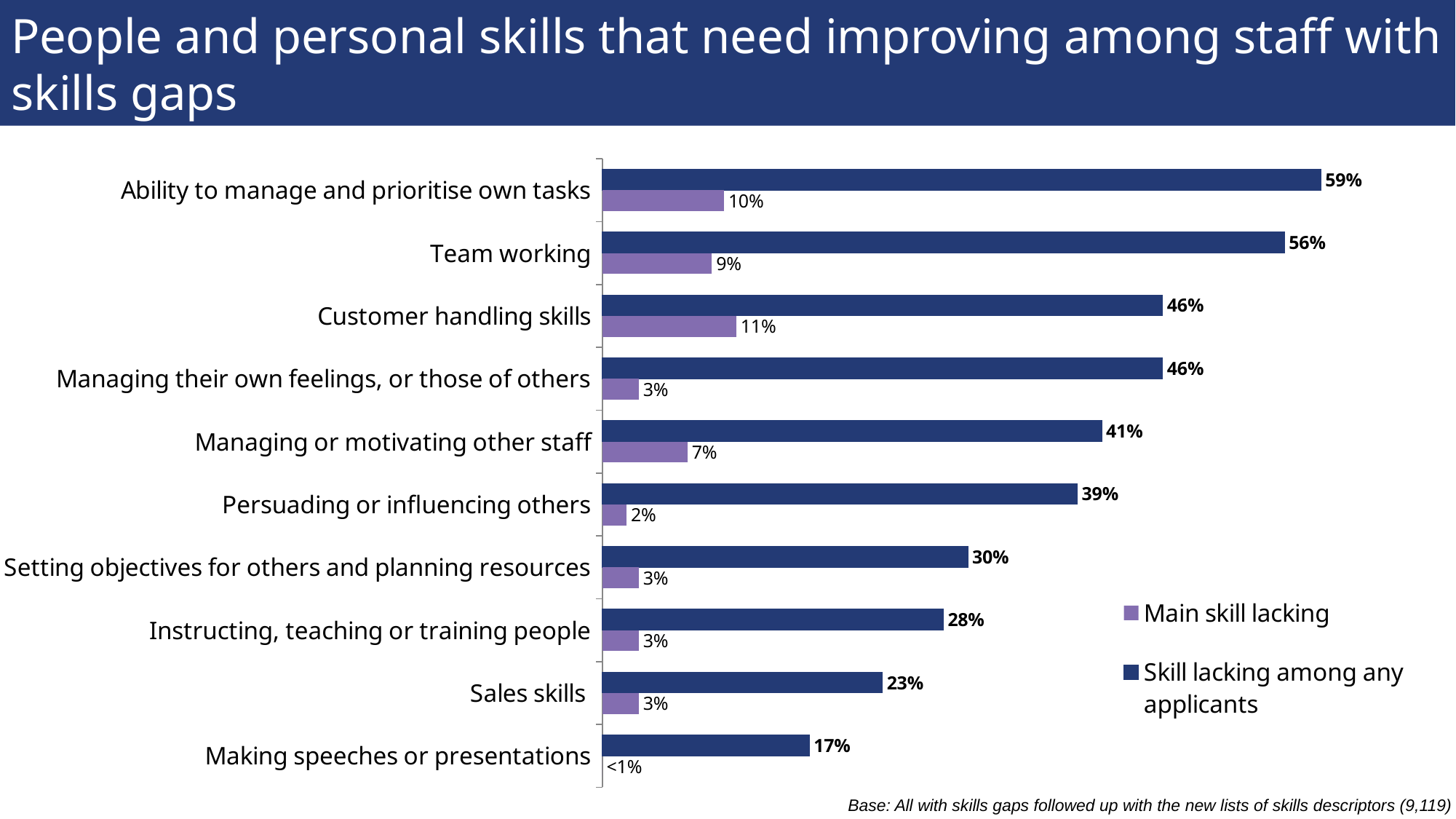
What is the value for 'Main skill lacking' for Customer handling skills? 11% What is the value for 'Main skill lacking' for Making speeches or presentations? <1% How many series does the legend list? 2 What is the value for 'Skill lacking among any applicants' for Team working? 56% What is the difference between the 'Skill lacking among any applicants' value and the 'Main skill lacking' value for Managing or motivating other staff? 34% Which category has the lowest value for 'Skill lacking among any applicants'? Making speeches or presentations How many skill categories are shown on the chart? 10 Which series is shown in purple in the legend? Main skill lacking Which is larger: the 'Skill lacking among any applicants' value for Sales skills or for Instructing, teaching or training people? Instructing, teaching or training people What kind of chart is shown on the slide? Bar chart Which category has the highest value for 'Main skill lacking'? Customer handling skills Which category has the highest value for 'Skill lacking among any applicants'? Ability to manage and prioritise own tasks